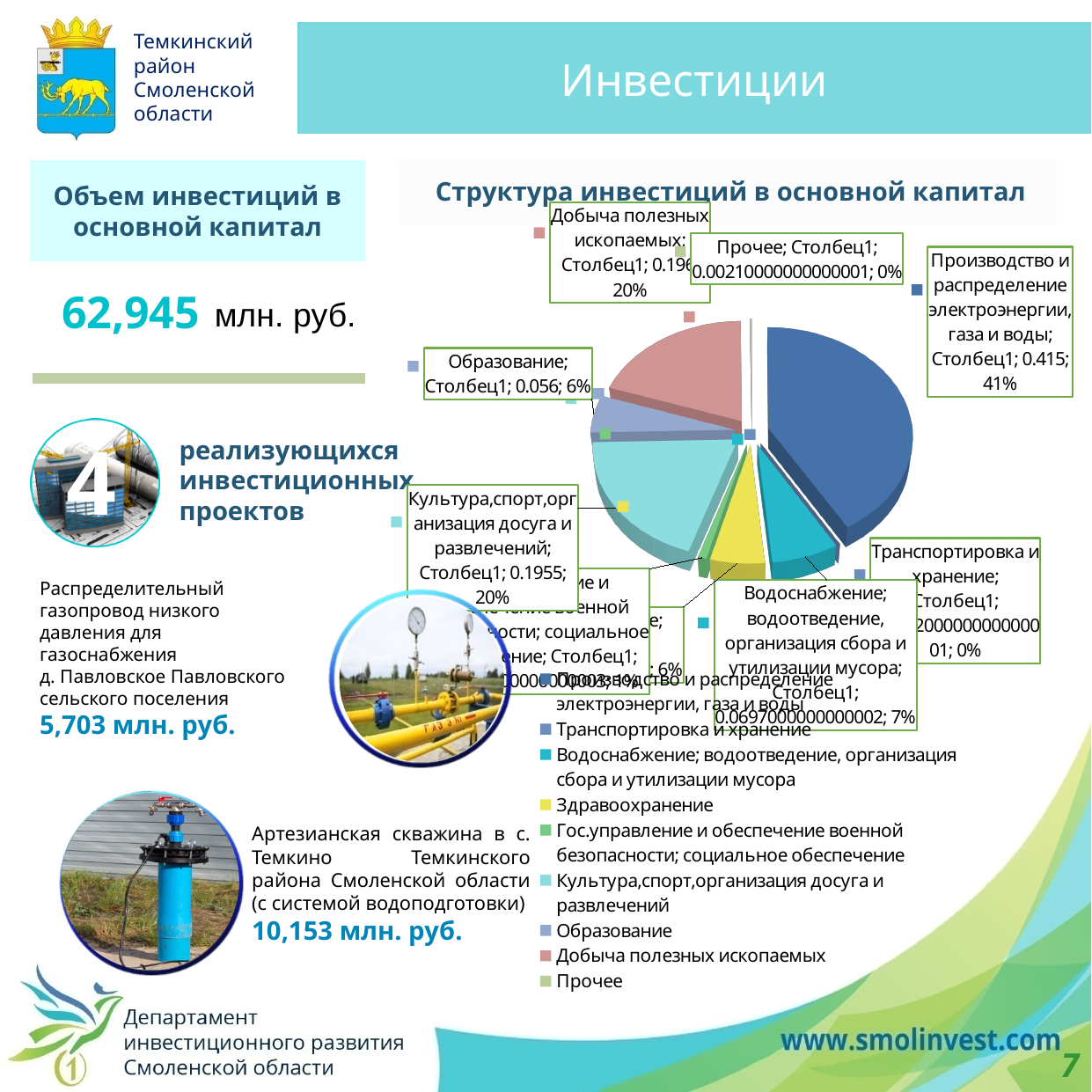
In the pie chart, what value is printed in the data label for "Производство и распределение электроэнергии, газа и воды" (before the percentage)? 0.415 What kind of chart is shown under the title "Структура инвестиций в основной капитал"? pie chart What is the title of the pie chart on the slide? Структура инвестиций в основной капитал In the pie chart, by how many percentage points does the share of "Производство и распределение электроэнергии, газа и воды" exceed that of "Добыча полезных ископаемых"? 21 In the pie chart, what percentage share is shown for "Образование"? 6% How many categories does the legend of the pie chart list? 9 In the pie chart, what percentage share is shown for "Производство и распределение электроэнергии, газа и воды"? 41% In the pie chart, what percentage share is shown for "Добыча полезных ископаемых"? 20% In the pie chart, what value is printed in the data label for "Образование" (before the percentage)? 0.056 In the pie chart, which share is larger: "Добыча полезных ископаемых" or "Образование"? Добыча полезных ископаемых In the pie chart "Структура инвестиций в основной капитал", which category has the largest share? Производство и распределение электроэнергии, газа и воды